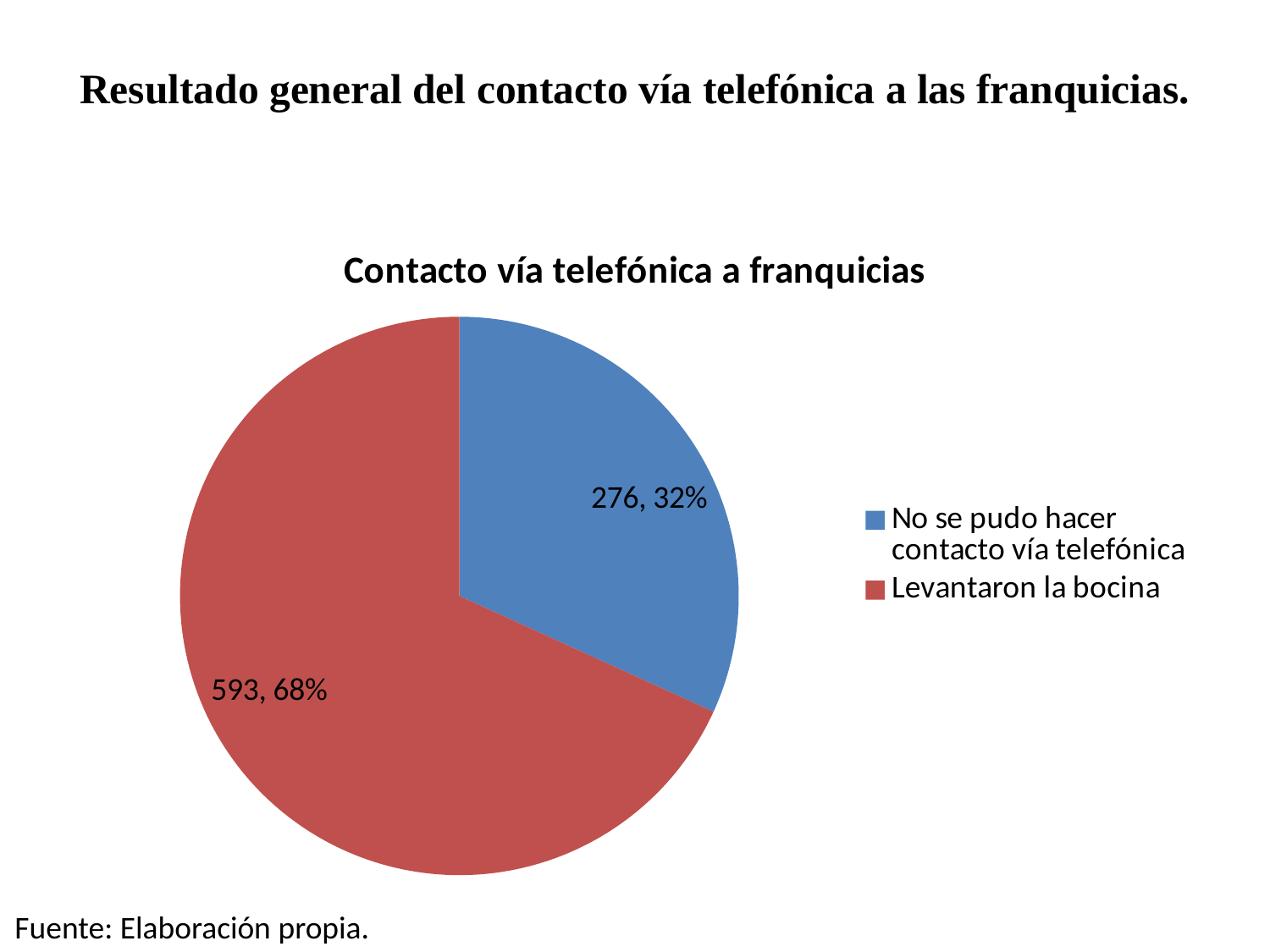
How many slices does the pie chart have? 2 What is the difference between the values for 'Levantaron la bocina' and 'No se pudo hacer contacto vía telefónica'? 317 What share of the pie does 'No se pudo hacer contacto vía telefónica' represent? 32% What type of chart is shown on the slide? pie chart Which category has the largest slice? Levantaron la bocina What is the title of the chart? Contacto vía telefónica a franquicias What share of the pie does 'Levantaron la bocina' represent? 68% What colour is the slice for 'No se pudo hacer contacto vía telefónica'? blue What is the value for 'No se pudo hacer contacto vía telefónica'? 276 What is the value for 'Levantaron la bocina'? 593 Which category has the smallest slice? No se pudo hacer contacto vía telefónica How many entries does the legend list? 2